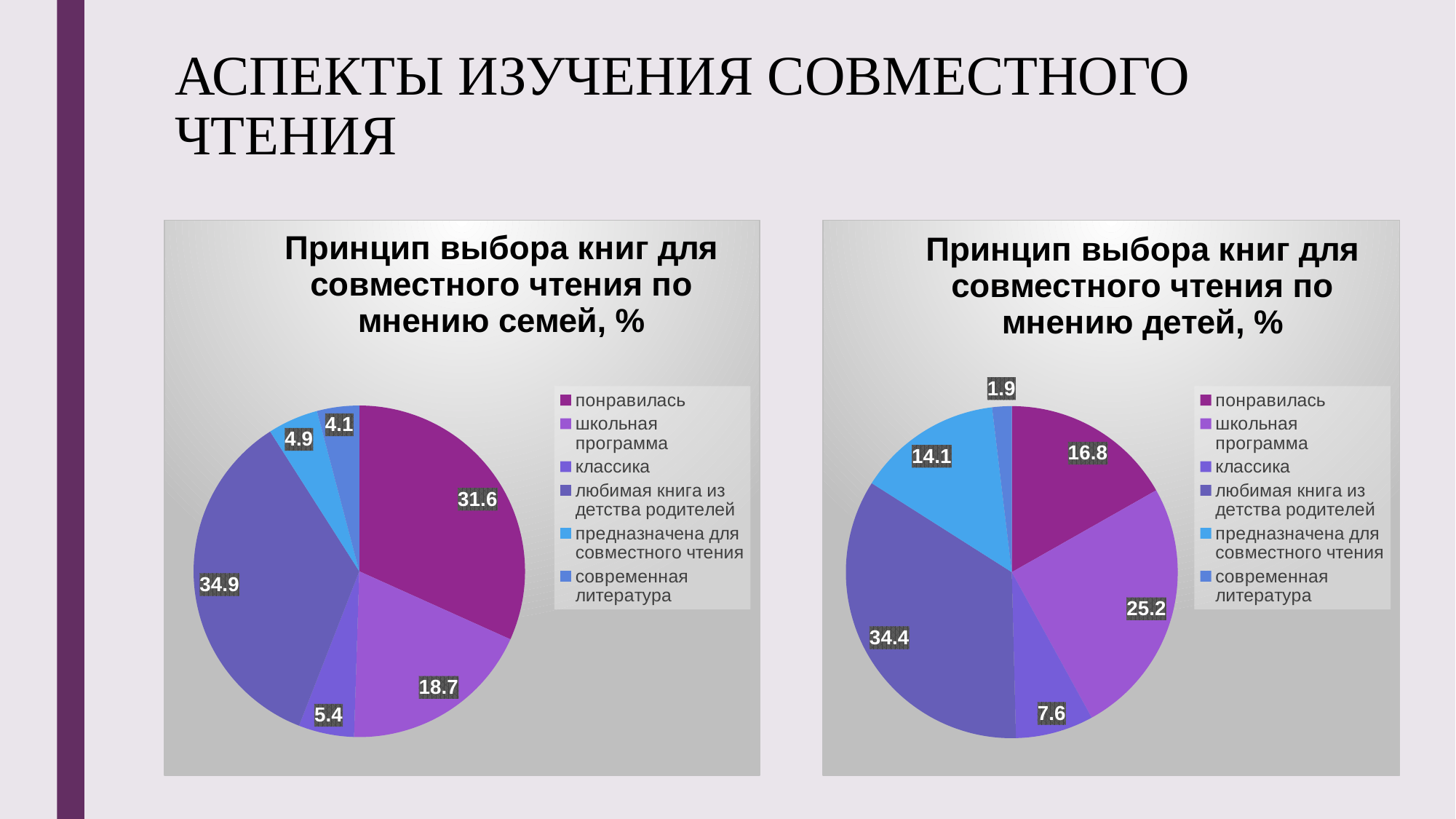
In the left chart (по мнению семей), which is larger: «школьная программа» or «классика»? школьная программа In the right chart (по мнению детей), what is the value for «предназначена для совместного чтения»? 14.1 In the right chart (по мнению детей), which is larger: «предназначена для совместного чтения» or «классика»? предназначена для совместного чтения In the left chart (по мнению семей), which category has the largest slice? любимая книга из детства родителей In the left chart (по мнению семей), what is the value for «понравилась»? 31.6 In the left chart (по мнению семей), which category has the smallest slice? современная литература How many categories does the legend of the left chart (по мнению семей) list? 6 In the right chart (по мнению детей), what is the difference between «любимая книга из детства родителей» and «понравилась»? 17.6 What is the title of the left chart? Принцип выбора книг для совместного чтения по мнению семей, % In the right chart (по мнению детей), what is the value for «школьная программа»? 25.2 In the right chart (по мнению детей), which category has the smallest slice? современная литература What type of chart is the right chart (по мнению детей)? pie chart